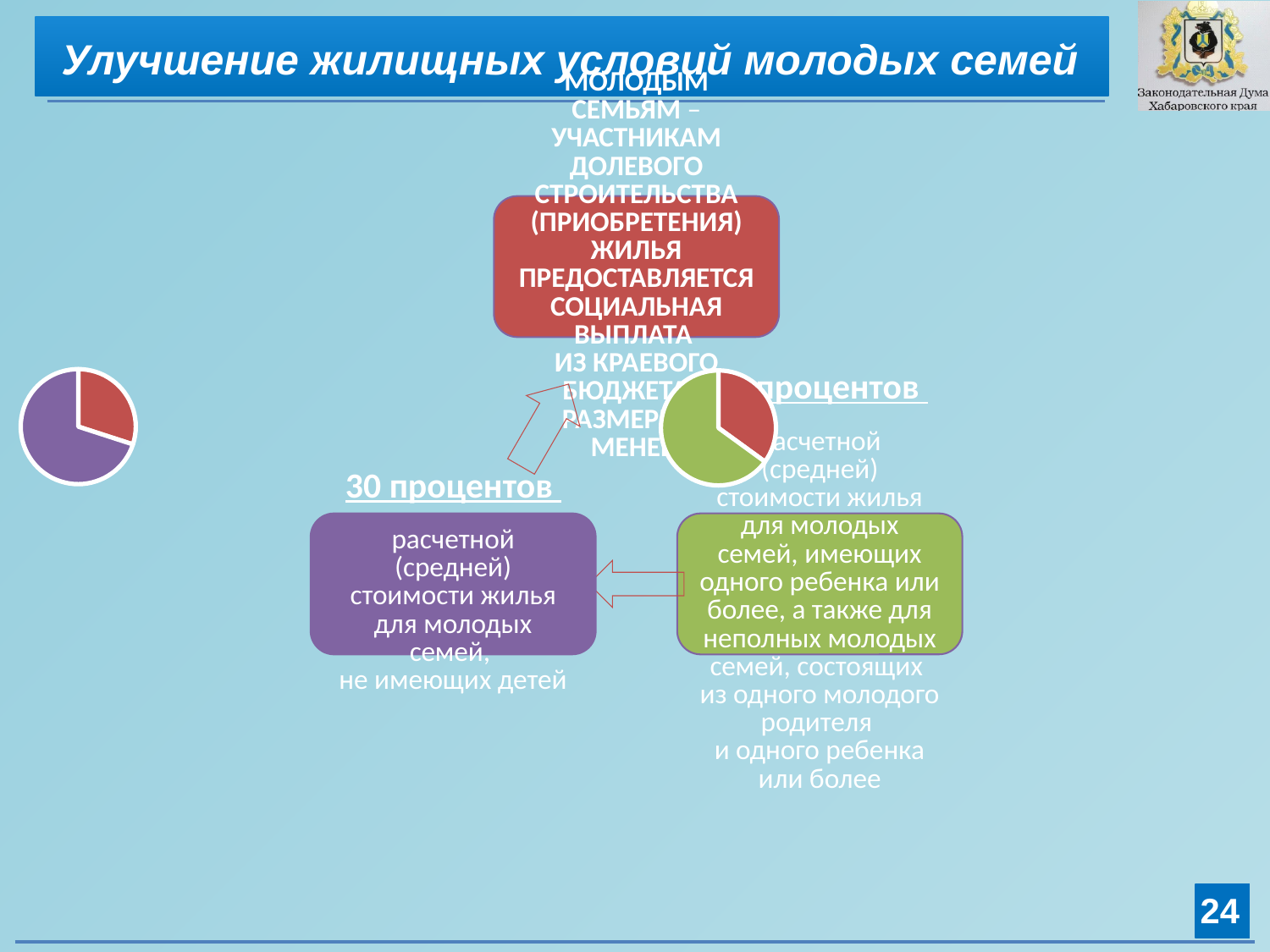
What two colours are used for the slices of the pie chart in the middle-right of the slide? green and red In the pie chart on the left side of the slide, is the red slice more or less than half of the pie? less In the pie chart in the middle-right of the slide, which slice is larger, the green one or the red one? the green one In the pie chart on the left side of the slide, which slice is larger, the purple one or the red one? the purple one How many slices does the pie chart in the middle-right of the slide have? 2 What kind of chart is the chart on the left side of the slide? pie chart What kind of chart is the chart in the middle-right of the slide, next to the green box? pie chart How many pie charts are shown on the slide? 2 How many slices does the pie chart on the left side of the slide have? 2 What two colours are used for the slices of the pie chart on the left side of the slide? purple and red